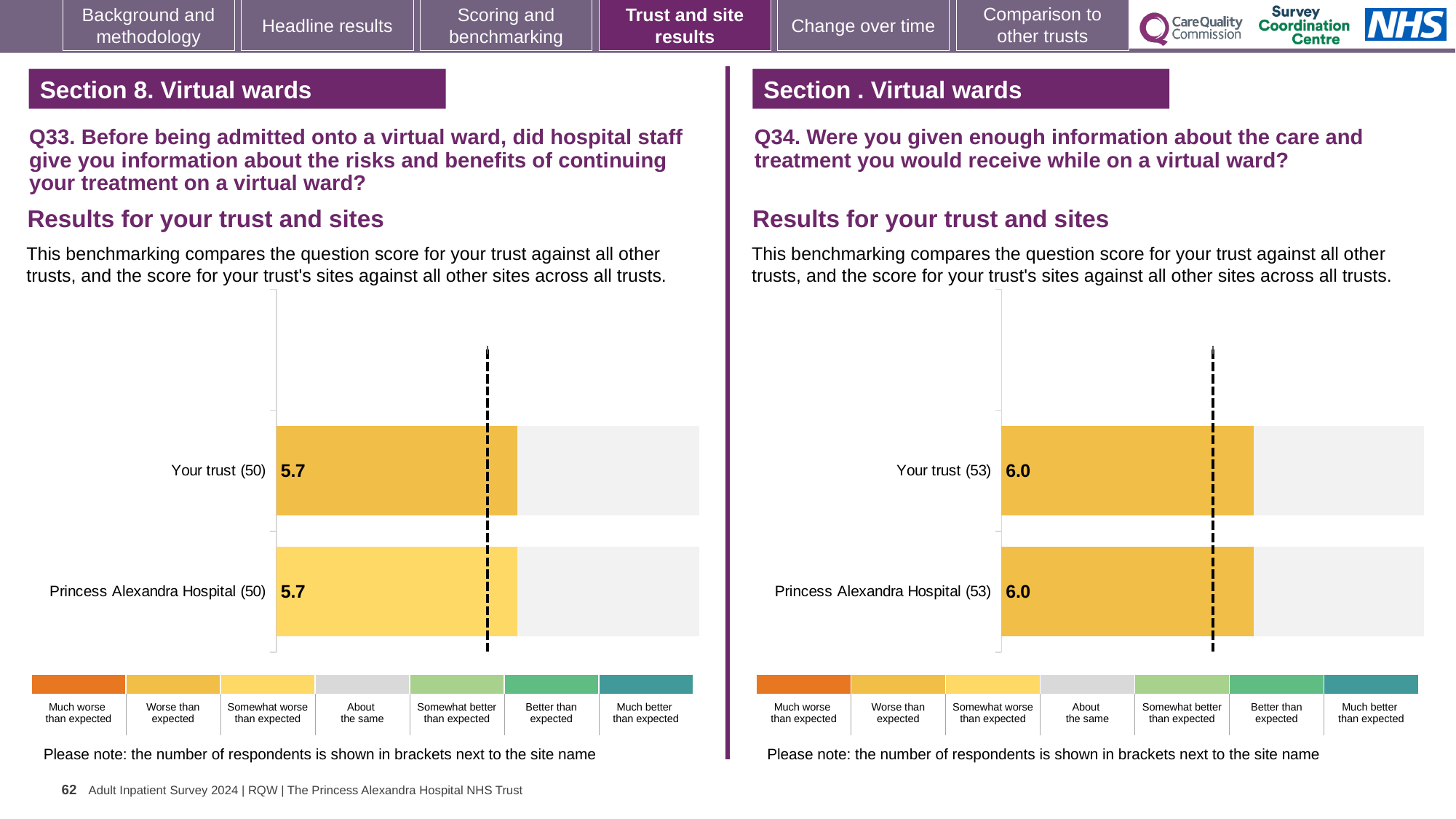
What kind of chart is the Q33 chart on the left? Bar chart In the Q34 chart on the right, how many respondents are shown in brackets for Your trust? 53 In the Q33 chart on the left, what is the score for Princess Alexandra Hospital (50)? 5.7 How many bars are plotted in the Q33 chart on the left? 2 In the Q33 chart on the left, what is the difference between the score for Your trust (50) and the score for Princess Alexandra Hospital (50)? 0.0 In the Q33 chart on the left, how many respondents are shown in brackets for Princess Alexandra Hospital? 50 How many bars are plotted in the Q34 chart on the right? 2 In the Q33 chart on the left, what is the score for Your trust (50)? 5.7 In the Q34 chart on the right, what is the difference between the score for Your trust (53) and the score for Princess Alexandra Hospital (53)? 0.0 In the Q34 chart on the right, what is the score for Your trust (53)? 6.0 In the Q34 chart on the right, what is the score for Princess Alexandra Hospital (53)? 6.0 Which is larger: the Your trust score in the Q33 chart on the left or the Your trust score in the Q34 chart on the right? Q34 chart on the right